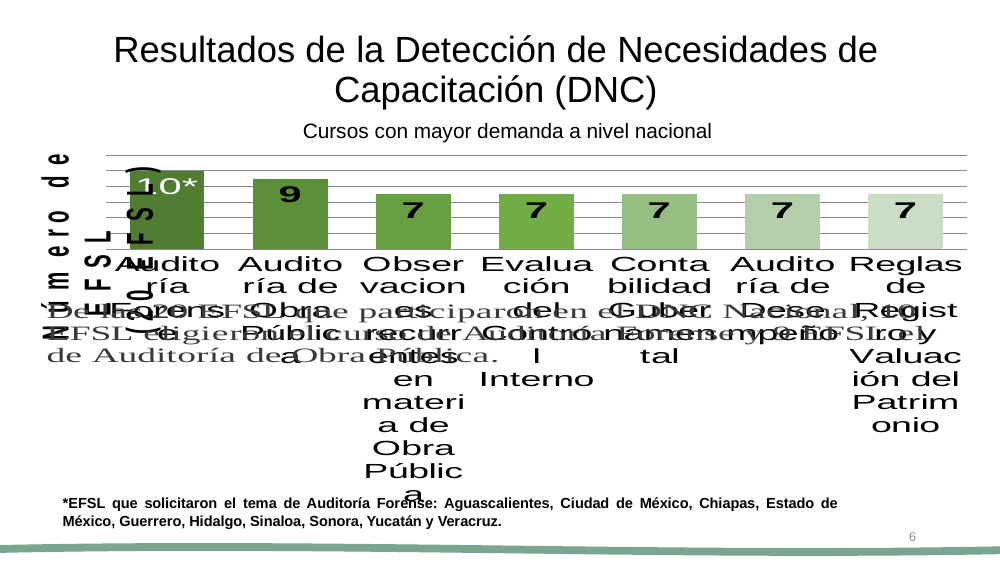
What value is shown for Contabilidad Gubernamental? 7 What kind of chart is shown on the slide? Bar chart What is the difference between the values for Auditoría Forense and Auditoría de Obra Pública? 1 Which is larger, the value for Auditoría de Obra Pública or the value for Contabilidad Gubernamental? Auditoría de Obra Pública What value is shown for Auditoría Forense? 10* How many categories are shown in the chart? 7 Do the values rise or fall from left to right across the chart? Fall What value is shown for Auditoría de Obra Pública? 9 What is the title of the chart? Cursos con mayor demanda a nivel nacional Which category has the highest value? Auditoría Forense What is the difference between the values for Auditoría de Obra Pública and Auditoría de Desempeño? 2 What value is shown for Evaluación del Control Interno? 7